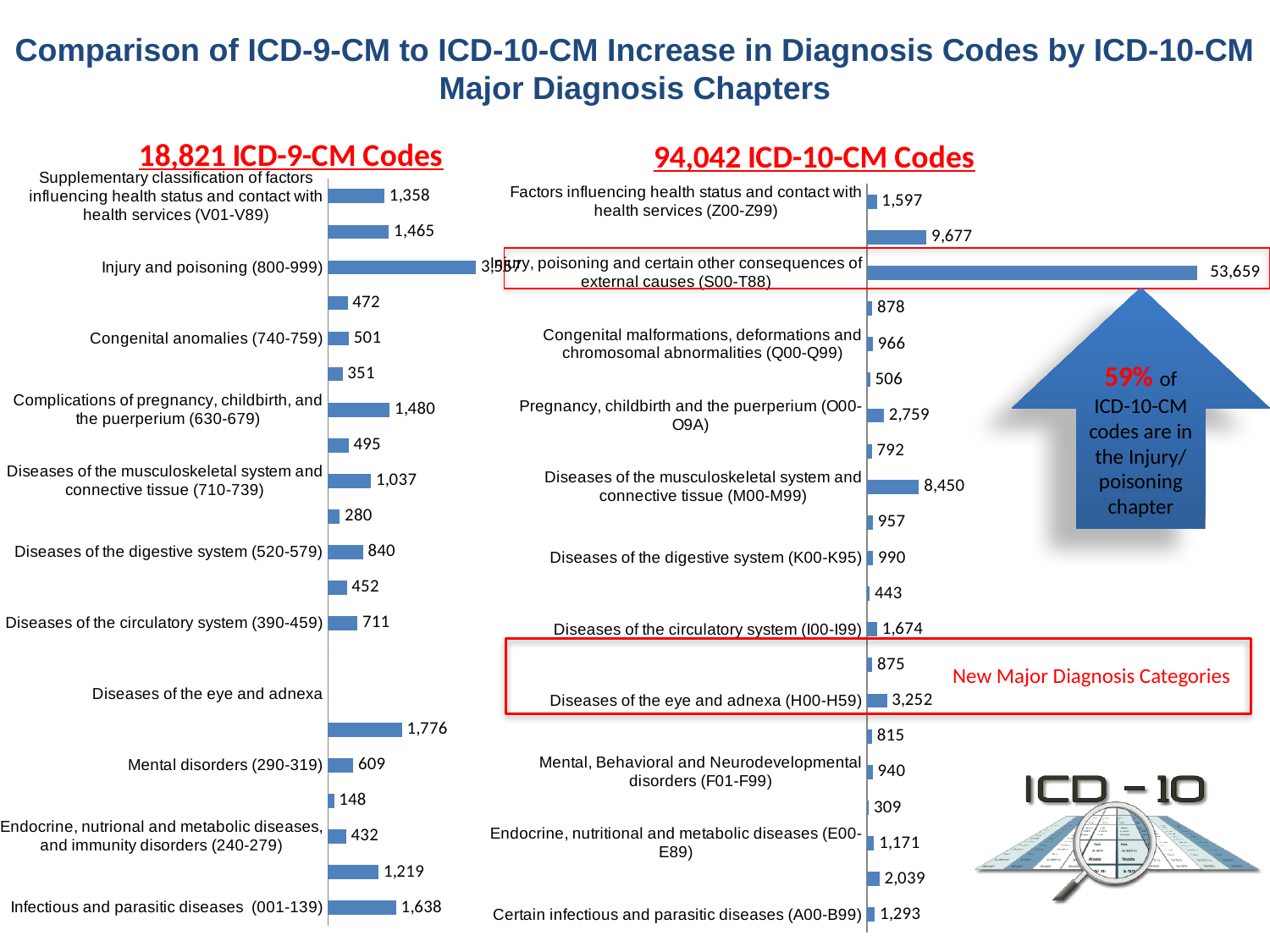
In the '18,821 ICD-9-CM Codes' chart, what is the value for Infectious and parasitic diseases (001-139)? 1,638 What type of chart is used to show the ICD-10-CM codes by chapter? Bar chart In the '94,042 ICD-10-CM Codes' chart, what is the value for Injury, poisoning and certain other consequences of external causes (S00-T88)? 53,659 In the '18,821 ICD-9-CM Codes' chart, what is the value for Complications of pregnancy, childbirth, and the puerperium (630-679)? 1,480 According to the callout on the slide, what percentage of ICD-10-CM codes are in the Injury/poisoning chapter? 59% In the '94,042 ICD-10-CM Codes' chart, which labeled category has the highest value? Injury, poisoning and certain other consequences of external causes (S00-T88) In the '18,821 ICD-9-CM Codes' chart, which is larger: Diseases of the digestive system (520-579) or Diseases of the circulatory system (390-459)? Diseases of the digestive system (520-579) In the '94,042 ICD-10-CM Codes' chart, what is the value for Diseases of the eye and adnexa (H00-H59)? 3,252 In the '94,042 ICD-10-CM Codes' chart, what is the value for Diseases of the musculoskeletal system and connective tissue (M00-M99)? 8,450 In the '18,821 ICD-9-CM Codes' chart, what is the difference between Mental disorders (290-319) and Endocrine, nutritional and metabolic diseases, and immunity disorders (240-279)? 177 In the '94,042 ICD-10-CM Codes' chart, what is the difference between Pregnancy, childbirth and the puerperium (O00-O9A) and Diseases of the circulatory system (I00-I99)? 1,085 In the '18,821 ICD-9-CM Codes' chart, which labeled category has the longest bar? Injury and poisoning (800-999)